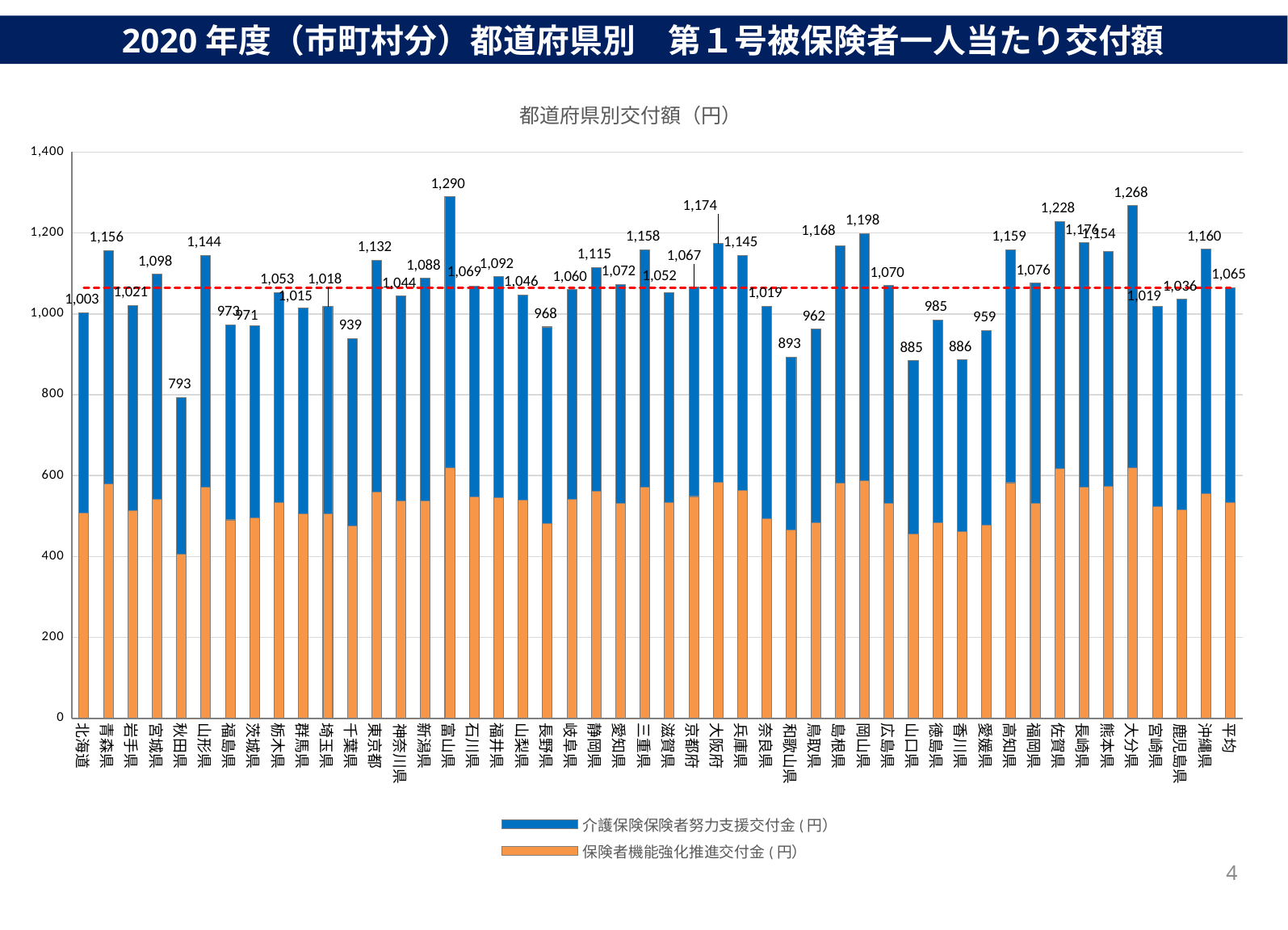
What is the total value shown for 秋田県? 793 What kind of chart is shown on the slide? Stacked bar chart Which prefecture has the highest total value? 富山県 What is the value shown for 平均? 1,065 Which prefecture has the lowest total value? 秋田県 Is the 保険者機能強化推進交付金 (orange) value for 秋田県 greater or less than 500? less What is the difference between the total values for 富山県 and 秋田県? 497 What is the total value shown for 大分県? 1,268 What is the total value shown for 富山県? 1,290 How many series does the legend list? 2 How many categories are shown on the x axis, including 平均? 48 Which has a larger total value, 青森県 or 岩手県? 青森県